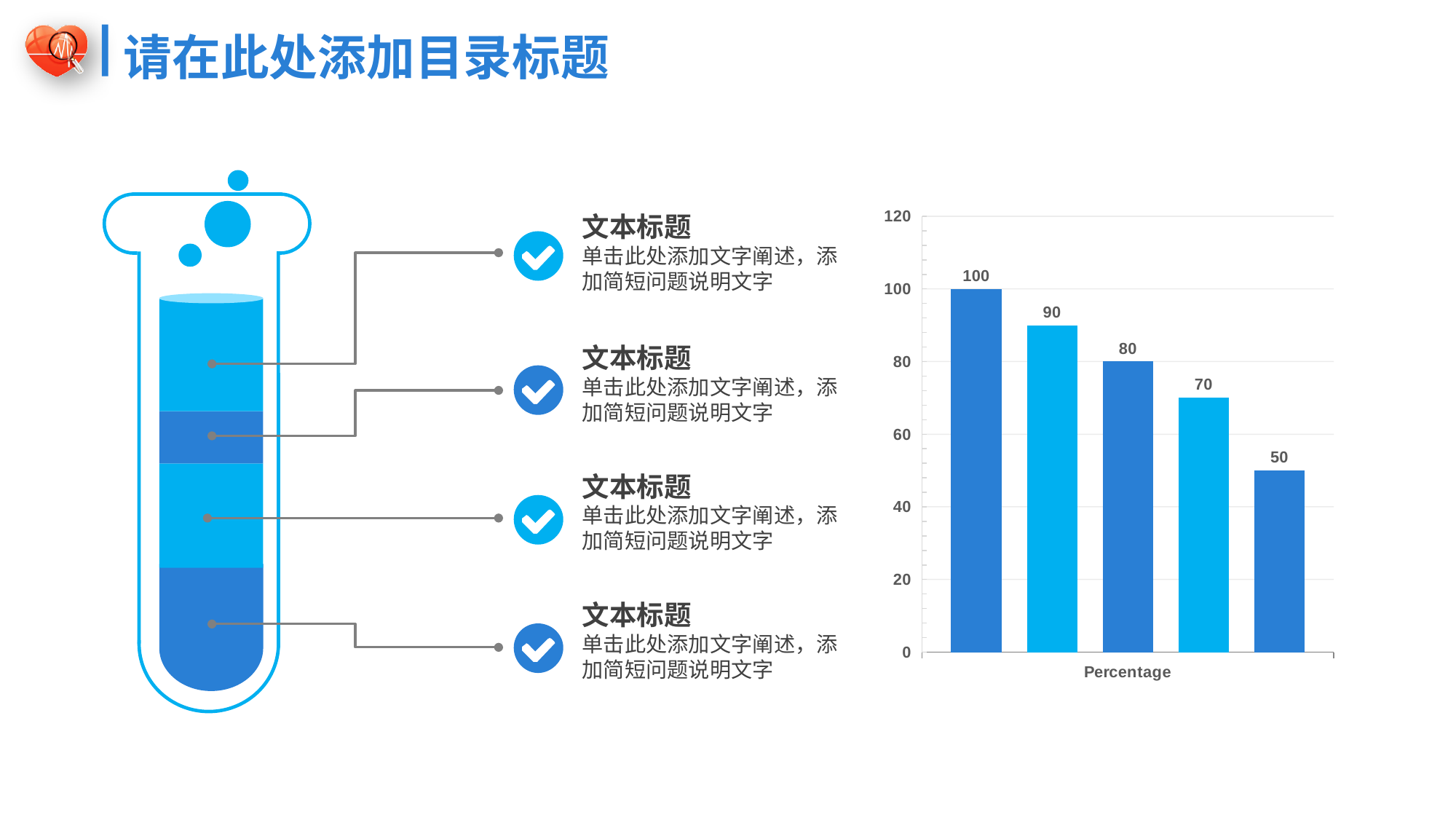
Which bar has the lowest value in the chart? the last (rightmost) bar, 50 What label is shown under the x axis of the chart? Percentage Do the bar values rise or fall from left to right along the x axis? fall How many bars are plotted in the bar chart? 5 What is the value of the first (leftmost) bar in the chart? 100 What is the difference between the second bar and the fourth bar? 20 What is the difference between the first bar (100) and the last bar (50)? 50 What kind of chart is shown on the right side of the slide? bar chart What is the value of the last (rightmost) bar in the chart? 50 What is the value of the third bar in the chart? 80 Which bar has the highest value in the chart? the first (leftmost) bar, 100 Which is larger, the second bar or the fourth bar? the second bar (90)